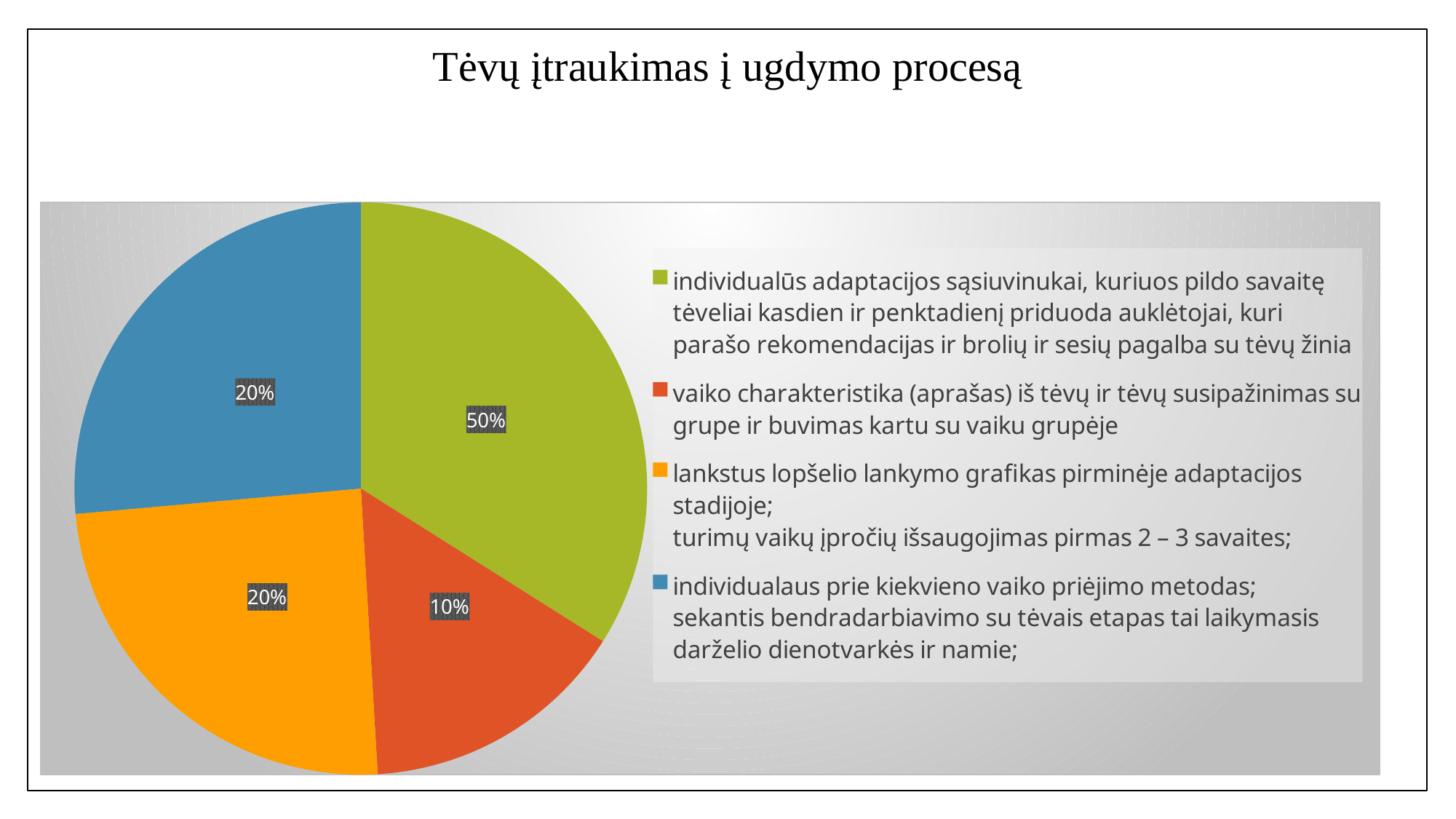
Which slice of the pie chart is the largest? individualūs adaptacijos sąsiuvinukai, kuriuos pildo savaitę tėveliai kasdien ir penktadienį priduoda auklėtojai, kuri parašo rekomendacijas ir brolių ir sesių pagalba su tėvų žinia What percentage is shown for the slice 'individualūs adaptacijos sąsiuvinukai...' (green)? 50% What share of the pie do the orange and blue slices make up together? 40% What percentage is shown for the slice 'individualaus prie kiekvieno vaiko priėjimo metodas...' (blue)? 20% What kind of chart is shown on the slide? pie chart Which is larger: the green slice ('individualūs adaptacijos sąsiuvinukai...') or the orange slice ('lankstus lopšelio lankymo grafikas...')? the green slice (individualūs adaptacijos sąsiuvinukai...) What percentage is shown for the slice 'vaiko charakteristika (aprašas) iš tėvų...' (red)? 10% What percentage is shown for the slice 'lankstus lopšelio lankymo grafikas...' (orange)? 20% How many slices does the pie chart have? 4 What is the difference in percentage points between the largest slice (50%) and the smallest slice (10%)? 40 percentage points What is the title of the slide? Tėvų įtraukimas į ugdymo procesą Which slice of the pie chart is the smallest? vaiko charakteristika (aprašas) iš tėvų ir tėvų susipažinimas su grupe ir buvimas kartu su vaiku grupėje